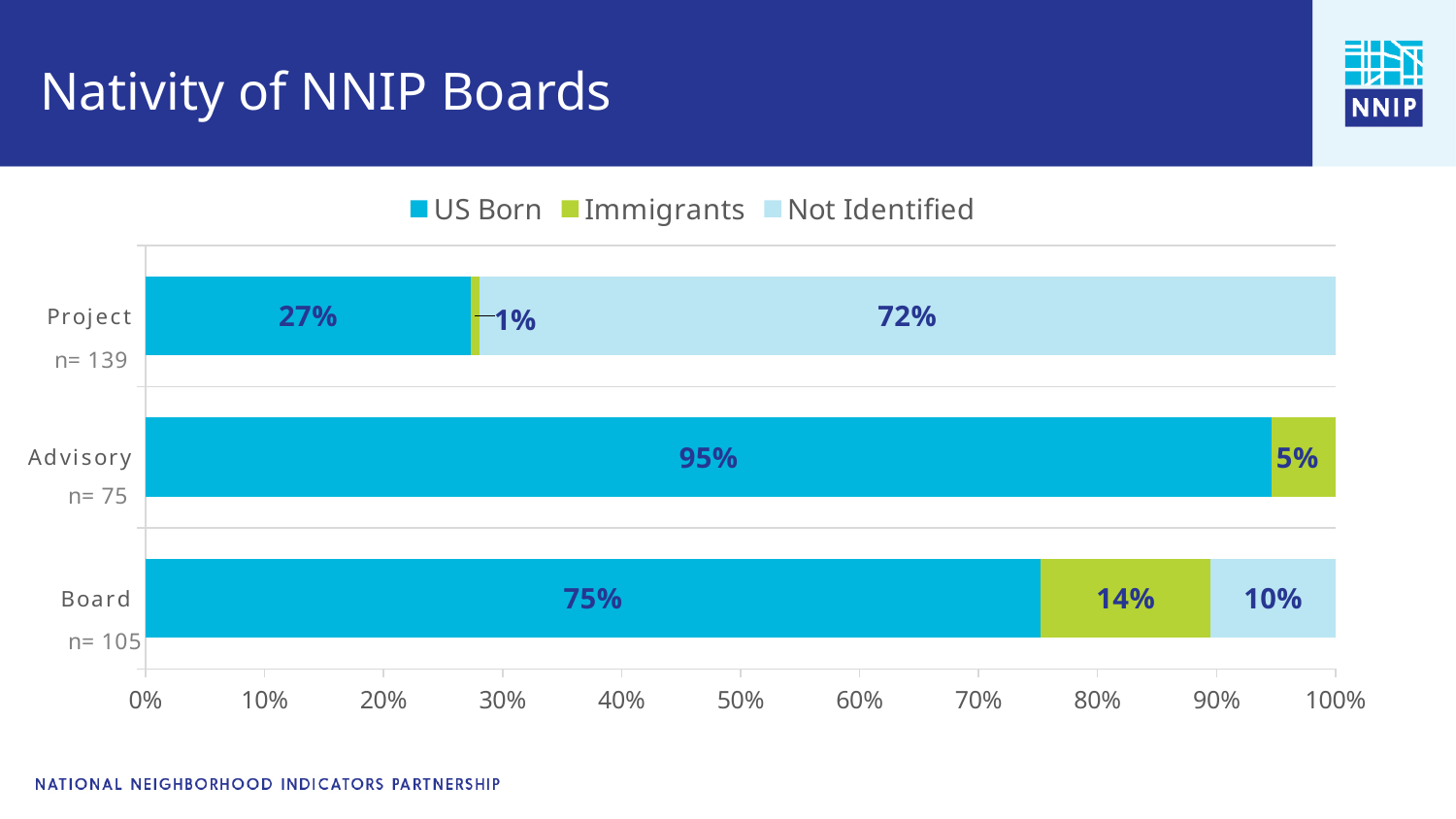
What is the sample size (n) for the Project board? 139 What percentage of the Project board is Not Identified? 72% Which board has the lowest US Born share? Project What percentage of the Advisory board is Immigrants? 5% How many series does the legend list? 3 What percentage of the Board is US Born? 75% How many boards are shown on the chart? 3 What percentage of the Board is Immigrants? 14% Which board has the highest US Born share? Advisory What kind of chart is shown on the slide? Stacked bar chart Which is larger: the Immigrants share of the Board or of the Advisory board? Board What is the difference between the US Born share of the Advisory board and the Board? 20%